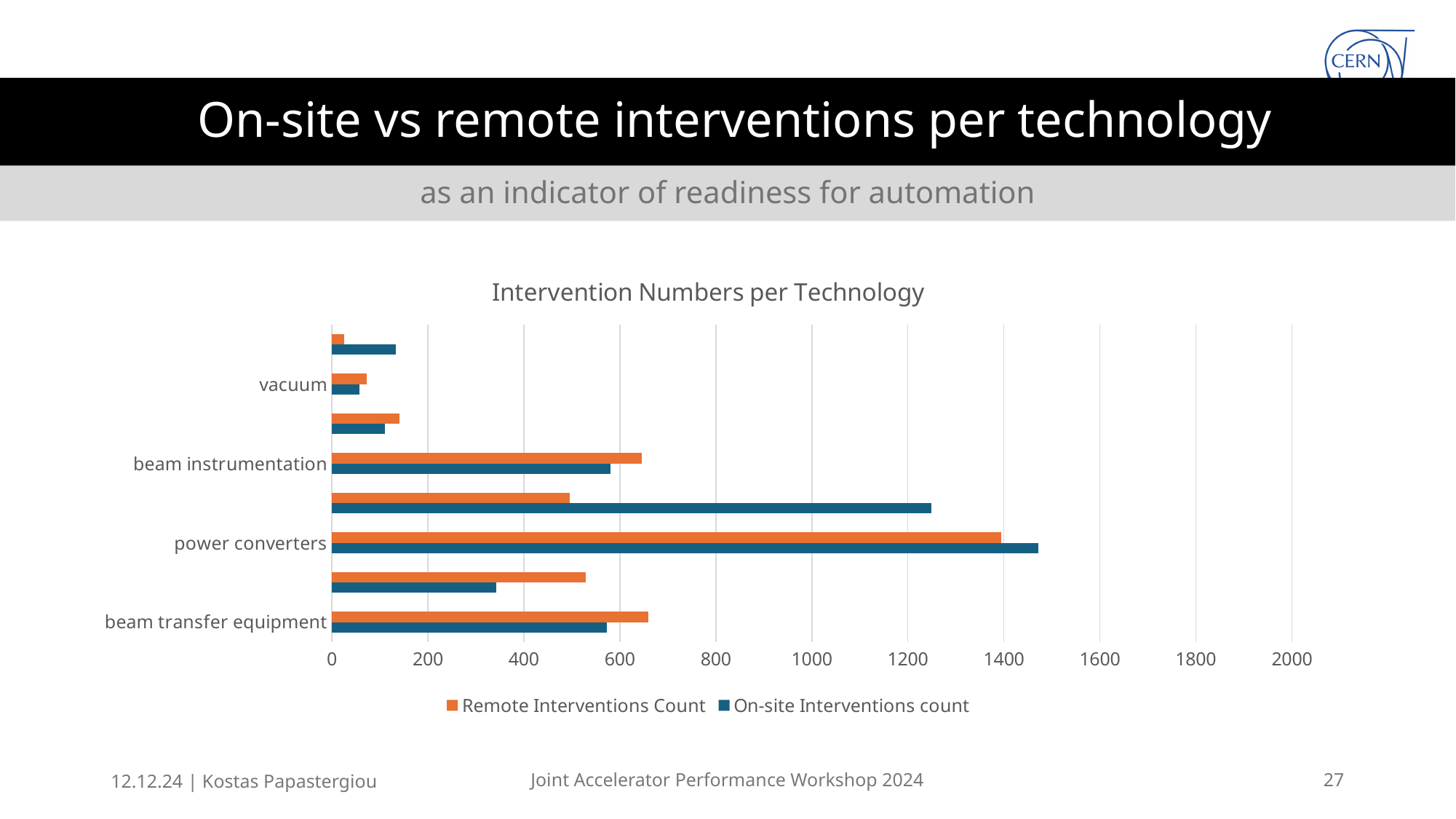
Is the On-site Interventions count for power converters greater or less than 1400? greater How many series does the legend list? 2 Which labelled technology has the highest Remote Interventions Count? power converters What kind of chart is shown on the slide? bar chart Which labelled technology has the highest On-site Interventions count? power converters What is the title of the chart? Intervention Numbers per Technology Which series is drawn in orange? Remote Interventions Count For beam transfer equipment, which is larger: the Remote Interventions Count or the On-site Interventions count? Remote Interventions Count Is the Remote Interventions Count for power converters greater or less than 1200? greater Is the Remote Interventions Count for beam transfer equipment greater or less than 600? greater For power converters, which is larger: the Remote Interventions Count or the On-site Interventions count? On-site Interventions count